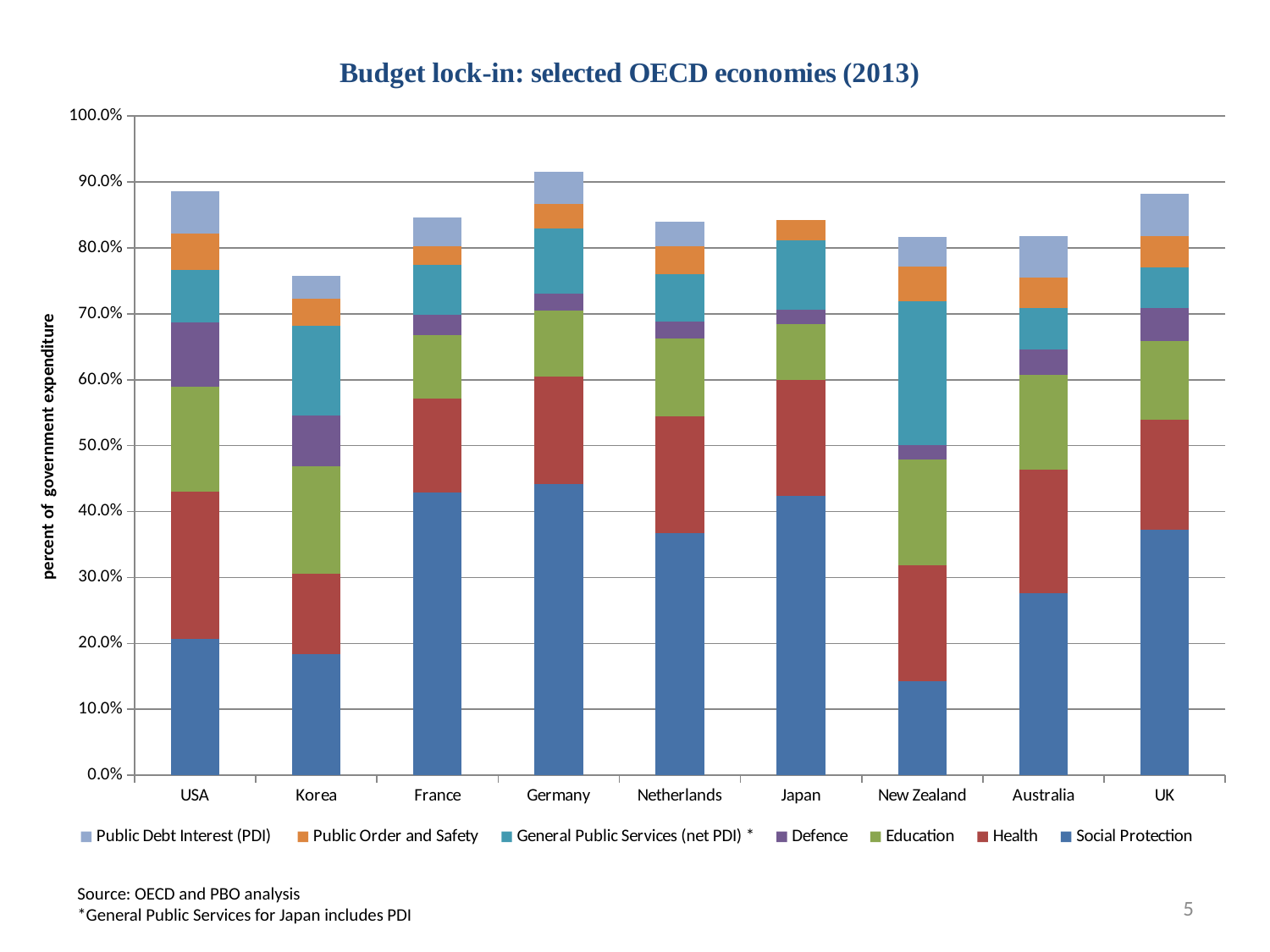
What is the title of the chart? Budget lock-in: selected OECD economies (2013) How many countries are shown on the x axis of the chart? 9 Is the Social Protection value for New Zealand greater or less than 20.0%? less Which has the larger Social Protection segment, France or Australia? France Which country has the highest total stacked bar? Germany Is the total stacked value for Korea greater or less than 80.0%? less Which country has the smallest Social Protection segment? New Zealand How many series does the legend list? 7 Which country has the lowest total stacked bar? Korea What kind of chart is shown on the slide? Stacked bar chart Is the total stacked value for Germany greater or less than 90.0%? greater